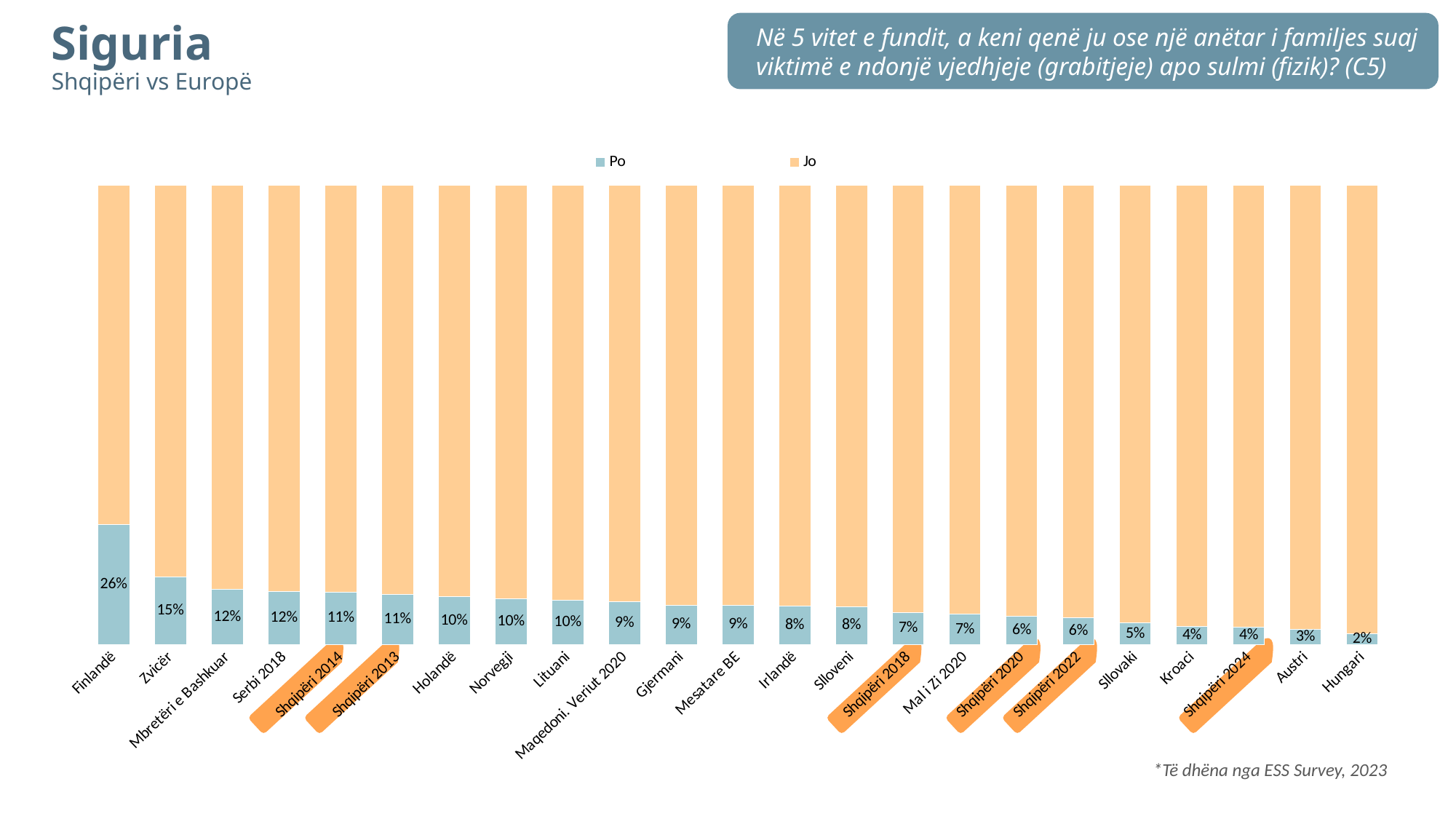
What is the "Po" value for Mesatare BE? 9% Which has a larger "Po" value, Zvicër or Austri? Zvicër What is the difference between the "Po" values for Finlandë and Zvicër? 11% What is the difference between the "Po" values for Shqipëri 2013 and Shqipëri 2024? 7% Which category has the highest "Po" value? Finlandë What is the "Po" value for Finlandë? 26% How many categories are shown on the x axis? 23 What kind of chart is shown on the slide? Stacked bar chart What is the "Po" value for Shqipëri 2013? 11% What is the "Po" value for Shqipëri 2024? 4% How many series does the legend list? 2 Which category has the lowest "Po" value? Hungari